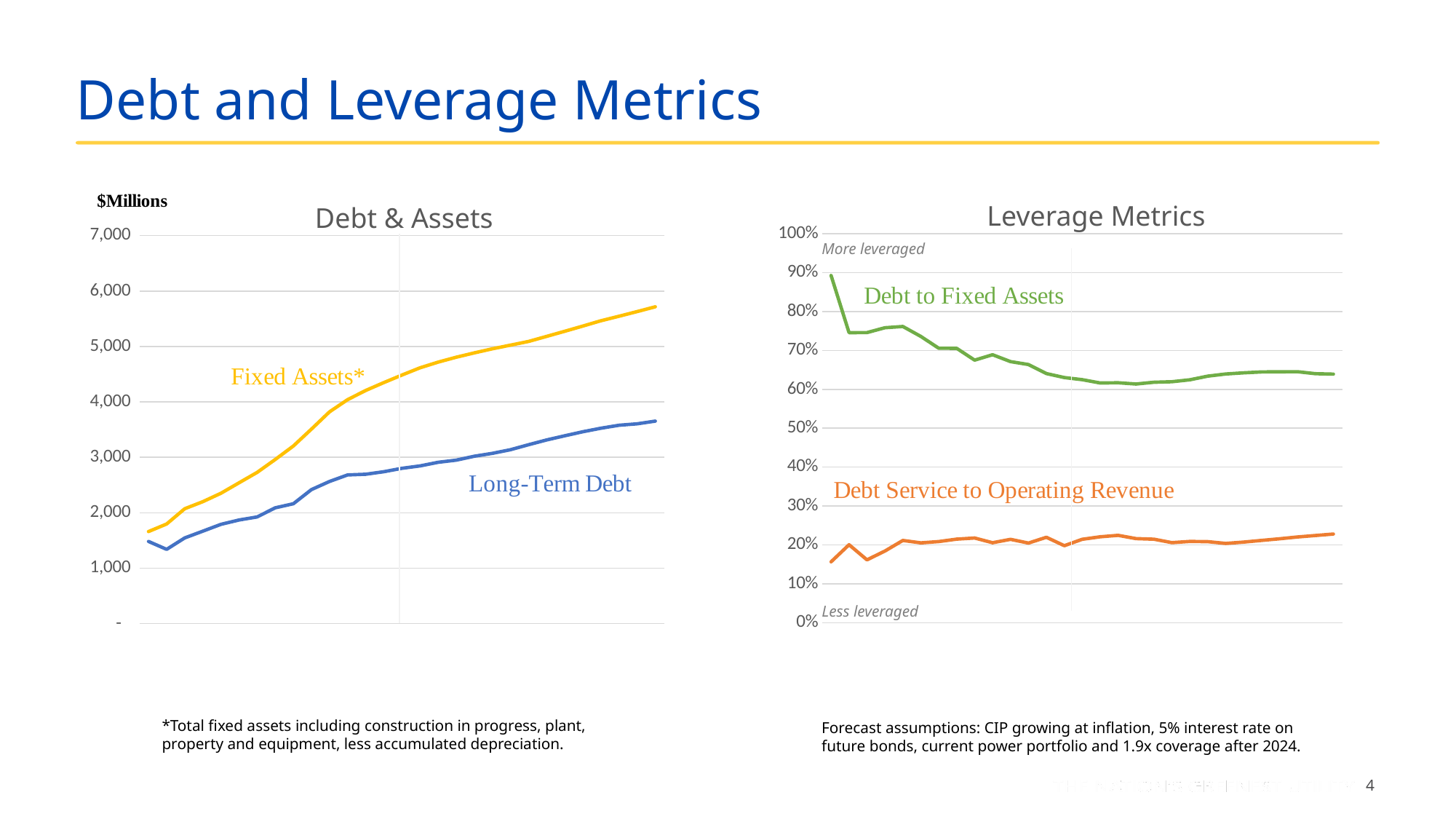
What kind of chart is the "Leverage Metrics" chart? line chart On the "Leverage Metrics" chart, is the final value of Debt Service to Operating Revenue greater or less than 30%? less How many series are plotted on the "Debt & Assets" chart? 2 On the "Debt & Assets" chart, is the final value of Fixed Assets* greater or less than 5,000? greater On the "Debt & Assets" chart, is the final value of Long-Term Debt greater or less than 4,000? less How many series are plotted on the "Leverage Metrics" chart? 2 What kind of chart is the "Debt & Assets" chart? line chart On the "Leverage Metrics" chart, which series is higher throughout: Debt to Fixed Assets or Debt Service to Operating Revenue? Debt to Fixed Assets On the "Debt & Assets" chart, does the Fixed Assets* line rise or fall from left to right? rise On the "Leverage Metrics" chart, does the Debt to Fixed Assets line rise or fall overall from left to right? fall What unit label is shown above the y axis of the "Debt & Assets" chart? $Millions